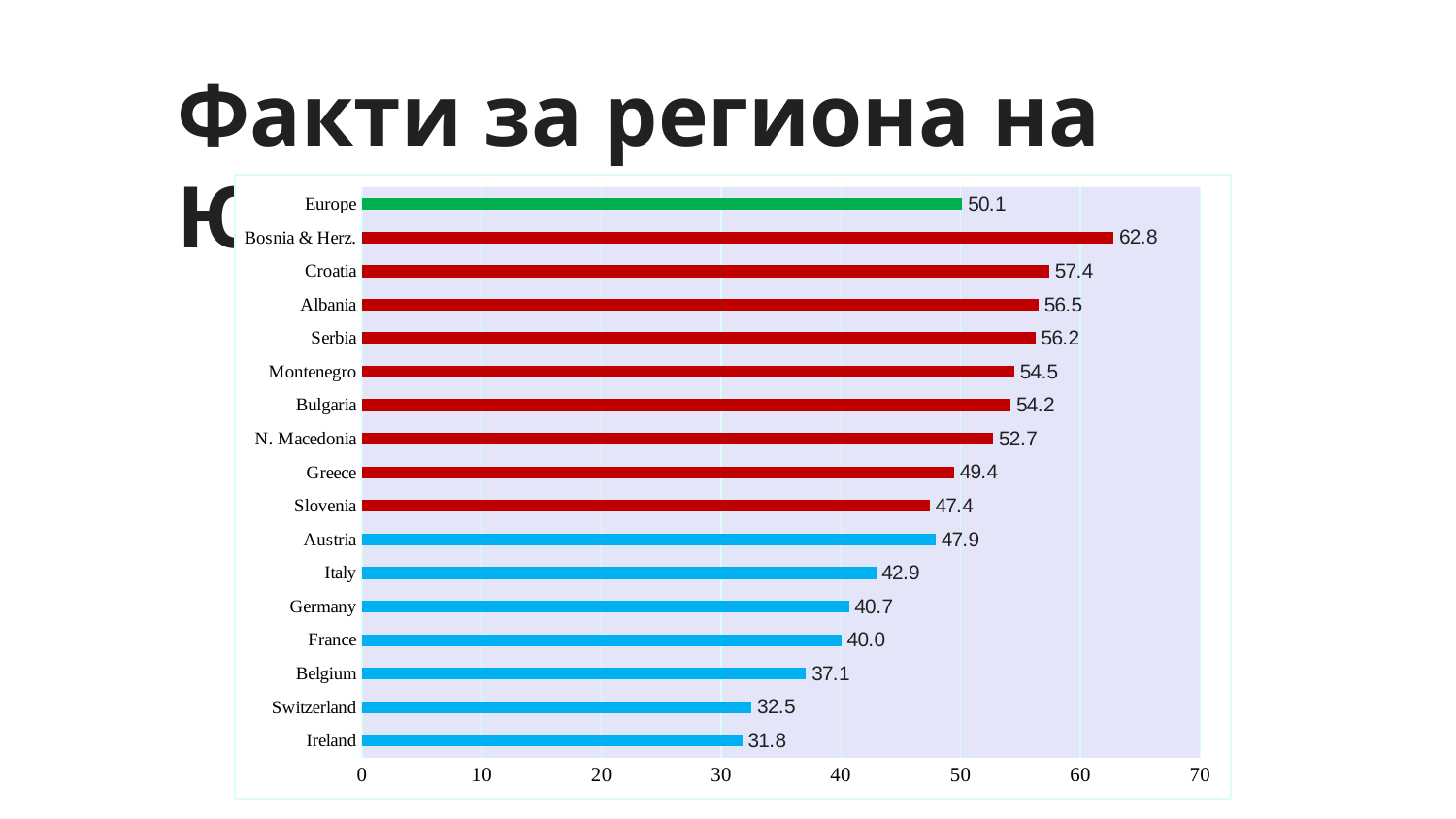
Which category has the highest value? Bosnia & Herz. What is the value for Bulgaria? 54.2 What is the value for Europe? 50.1 Which is larger, the value for Serbia or the value for Italy? Serbia Which category has the lowest value? Ireland What is the difference between the values for Bulgaria and Greece? 4.8 What is the value for Bosnia & Herz.? 62.8 How many categories are shown in the chart? 17 What is the value for Switzerland? 32.5 What is the difference between the values for Bosnia & Herz. and Ireland? 31.0 Is the value for Belgium greater or less than 40? less What kind of chart is shown on the slide? Bar chart